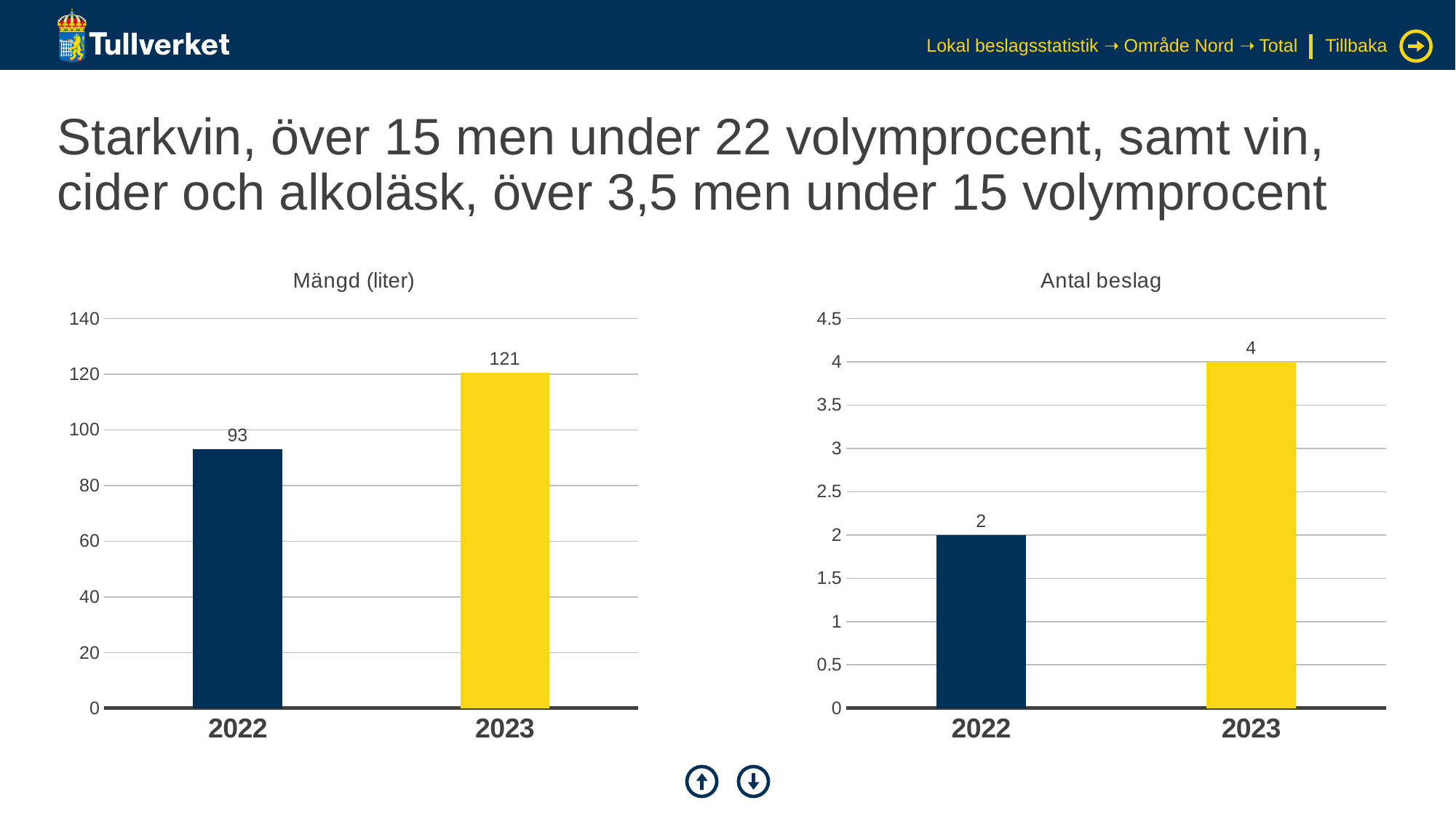
In the 'Mängd (liter)' chart, which year has the highest value? 2023 In the 'Mängd (liter)' chart, what is the value for 2023? 121 In the 'Antal beslag' chart, do the values rise or fall from 2022 to 2023? rise In the 'Antal beslag' chart, what is the value for 2022? 2 In the 'Mängd (liter)' chart, what is the value for 2022? 93 In the 'Antal beslag' chart, what is the value for 2023? 4 How many categories are shown on the x axis of the 'Antal beslag' chart? 2 In the 'Mängd (liter)' chart, is the value for 2022 greater or less than 100? less What kind of chart is the 'Mängd (liter)' chart? bar chart In the 'Antal beslag' chart, which year has the lowest value? 2022 In the 'Mängd (liter)' chart, what is the difference between the 2023 and 2022 values? 28 In the 'Antal beslag' chart, what is the difference between the 2023 and 2022 values? 2